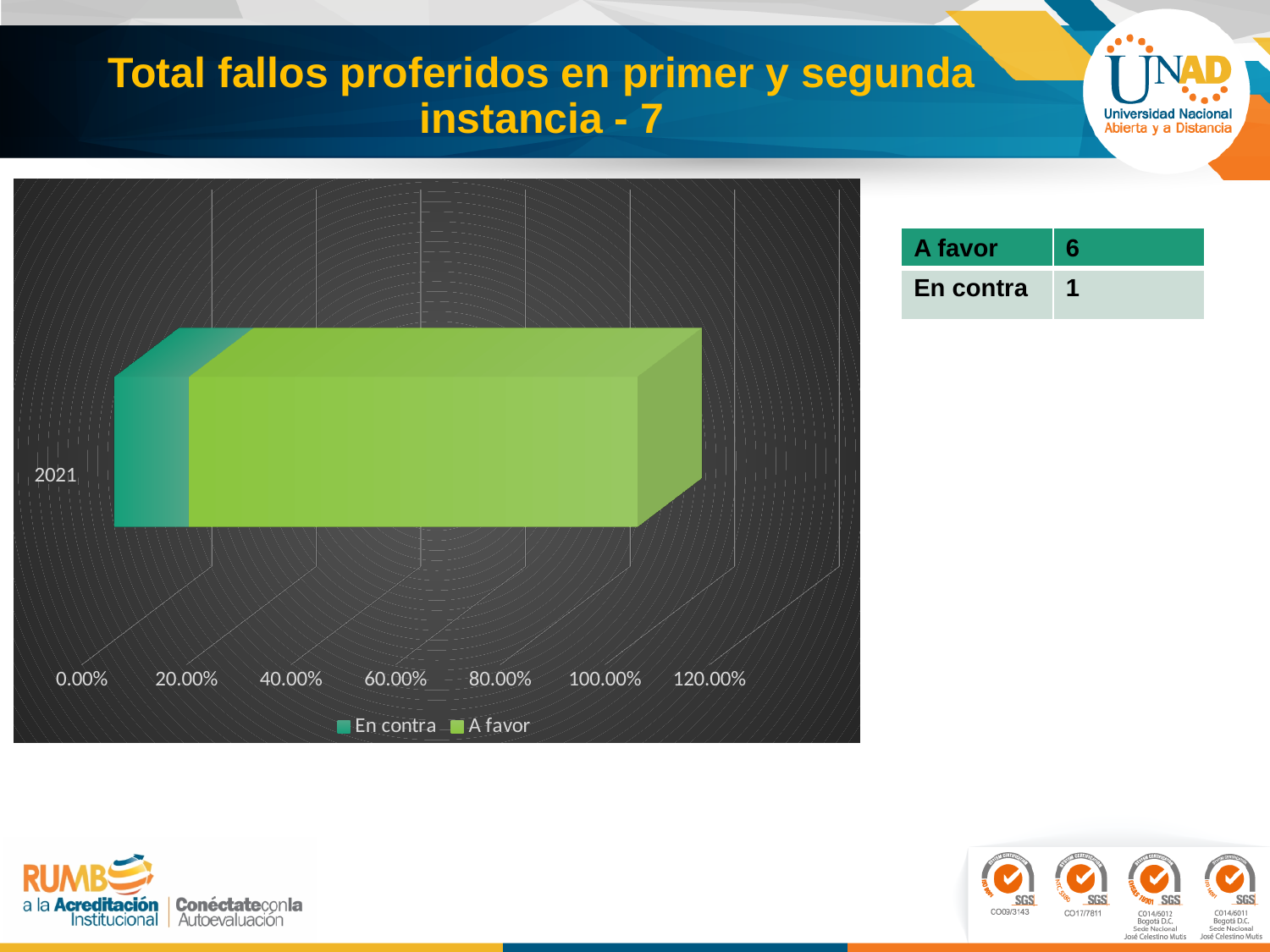
Which two series are listed in the chart legend? En contra and A favor According to the table next to the chart, what is the value for En contra? 1 How many categories are plotted on the chart's vertical axis? 1 According to the table next to the chart, what is the value for A favor? 6 Which series has the largest segment in the 2021 bar? A favor Using the table next to the chart, what is the difference between the A favor and En contra values? 5 Which series occupies the larger share of the 2021 bar, En contra or A favor? A favor How many series does the chart legend list? 2 What is the title of the slide containing the chart? Total fallos proferidos en primer y segunda instancia - 7 What kind of chart is shown on the slide? Bar chart Is the A favor segment of the 2021 bar greater or less than 60.00% wide? greater Which series has the smallest segment in the 2021 bar? En contra